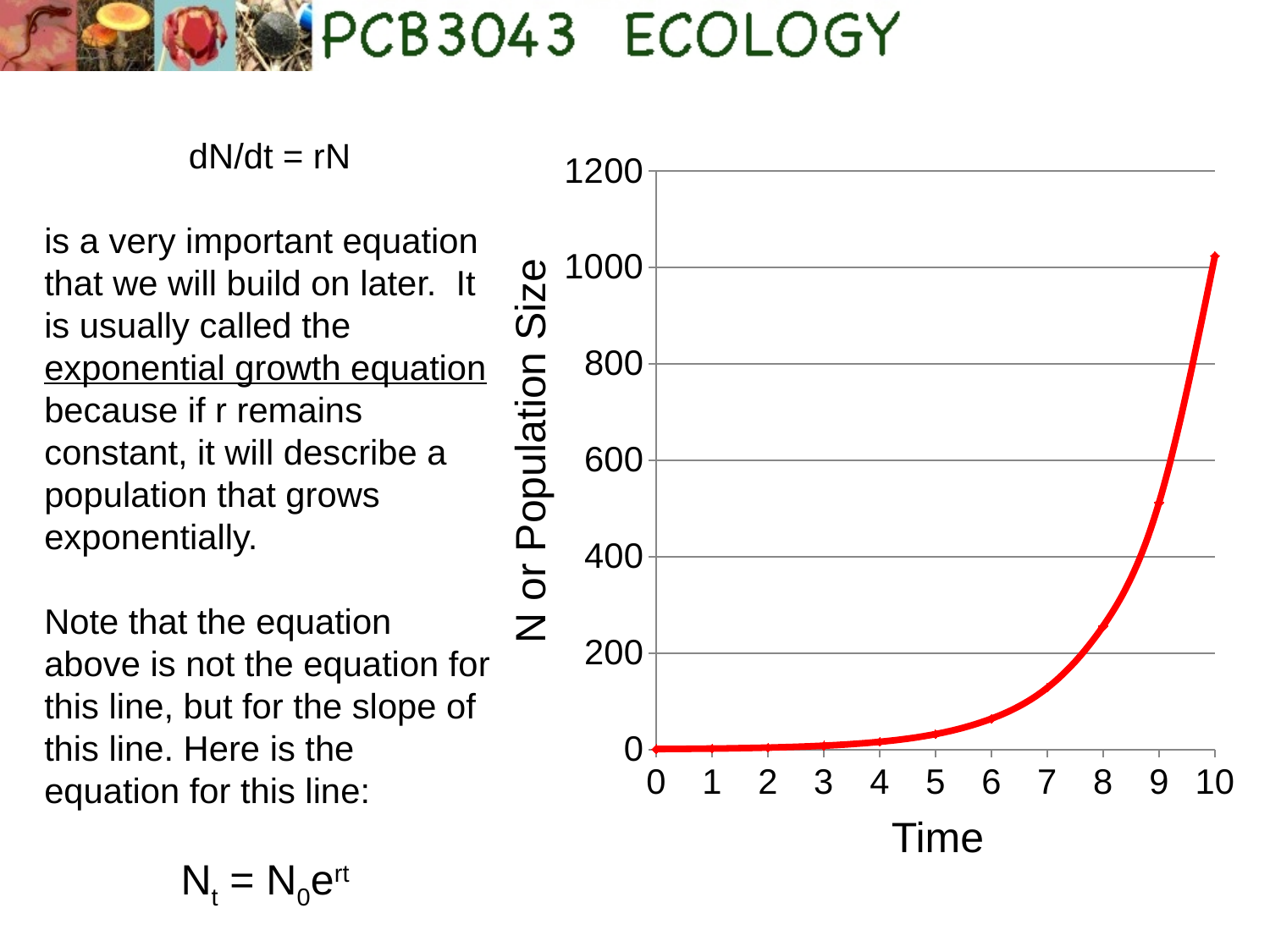
Which is larger, the population size at Time 9 or at Time 7? Time 9 What is the title of the x axis of the chart? Time Is the population size at Time 9 greater or less than 600? less How many data points are plotted on the line (Time 0 through 10)? 11 Is the population size at Time 8 greater or less than 400? less Does the population size rise or fall as Time increases along the x axis? rise What kind of chart is shown on the slide? line chart Is the population size at Time 9 greater or less than 400? greater At which Time value is the population size lowest? 0 At which Time value is the population size highest? 10 What is the title of the y axis of the chart? N or Population Size